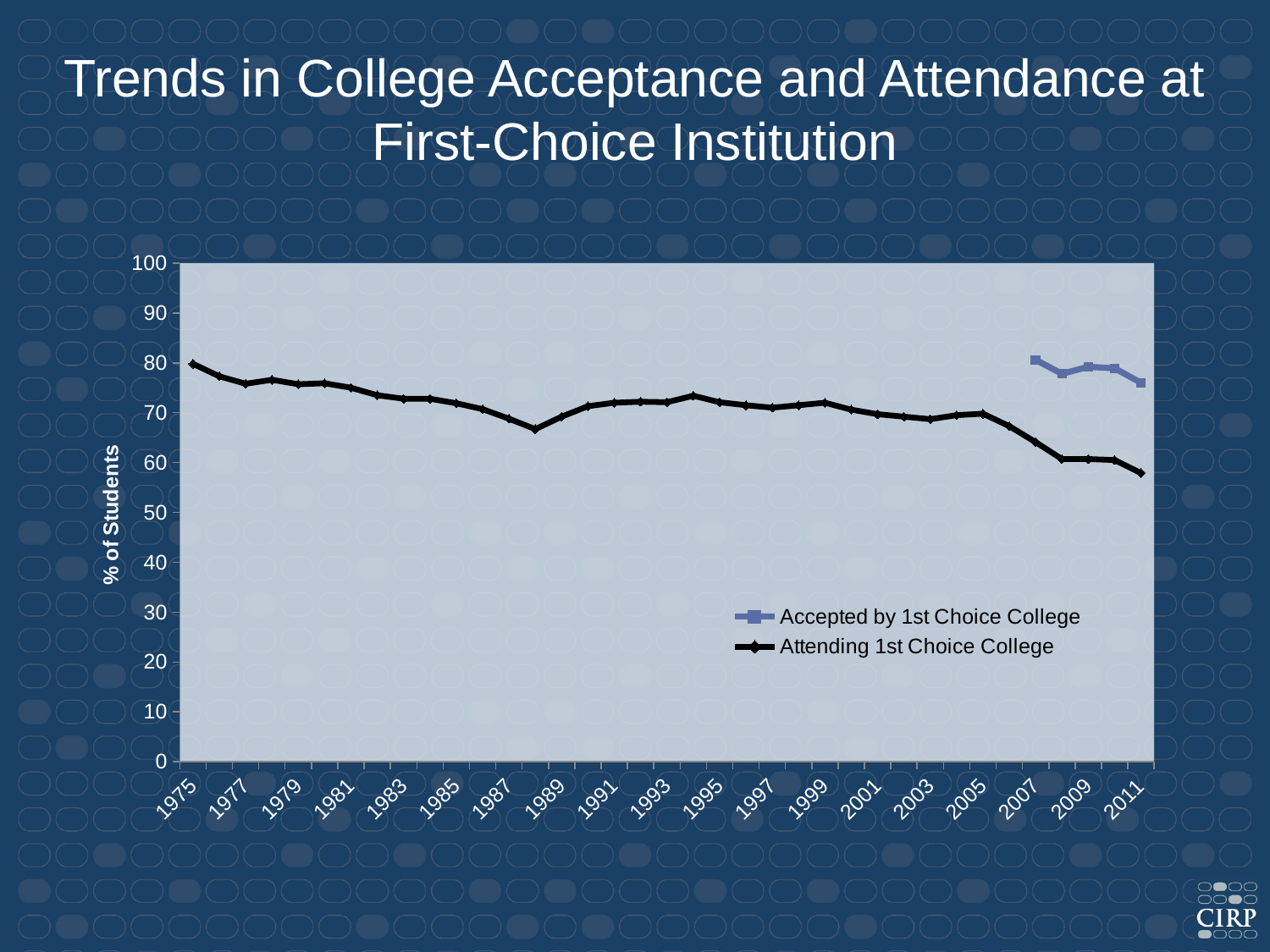
Is the Attending 1st Choice College value for 2009 greater or less than 70? less In which year is the Attending 1st Choice College value highest? 1975 What are the two series named in the legend? Accepted by 1st Choice College; Attending 1st Choice College What kind of chart is shown on the slide? line chart How many series does the legend list? 2 Does the Attending 1st Choice College line rise or fall overall from 1975 to 2011? fall In which year is the Attending 1st Choice College value lowest? 2011 Is the Attending 1st Choice College value for 1975 greater or less than 70? greater What is the label on the vertical axis? % of Students Is the Accepted by 1st Choice College value for 2007 greater or less than 70? greater In 2011, which is larger: Accepted by 1st Choice College or Attending 1st Choice College? Accepted by 1st Choice College Does the Accepted by 1st Choice College line rise or fall from 2007 to 2011? fall